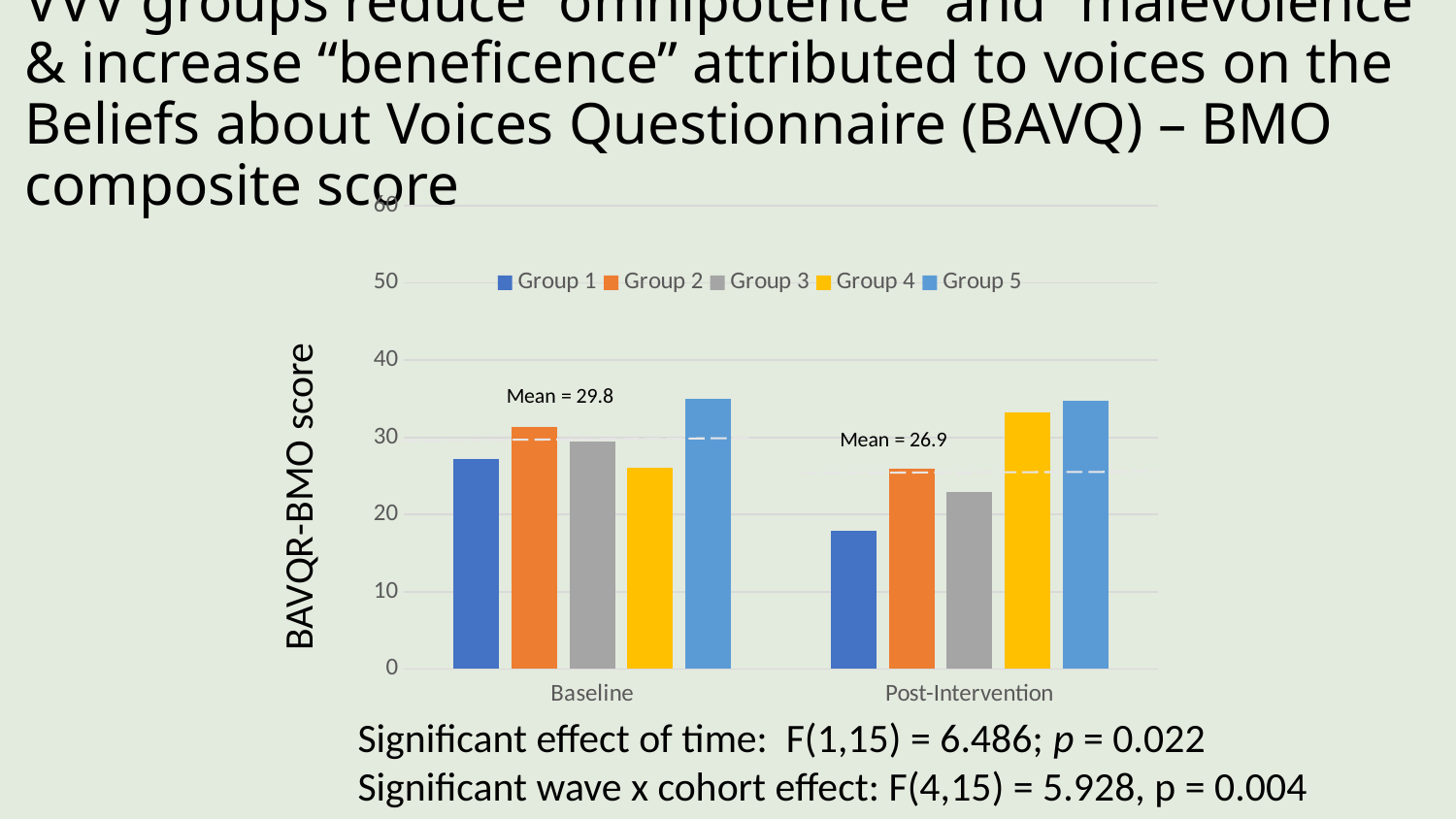
Is the Post-Intervention value for Group 1 greater or less than 20? less What kind of chart is shown on the slide? Bar chart Is the Baseline value for Group 5 greater or less than 30? greater For Group 4, is the score larger at Baseline or at Post-Intervention? Post-Intervention What is the mean BAVQR-BMO score shown for Baseline? 29.8 Which group has the highest BAVQR-BMO score at Baseline? Group 5 Which group has the lowest BAVQR-BMO score at Post-Intervention? Group 1 What is the mean BAVQR-BMO score shown for Post-Intervention? 26.9 What is the label on the y axis of the chart? BAVQR-BMO score What is the difference between the Baseline mean and the Post-Intervention mean? 2.9 How many series does the chart legend list? 5 How many categories are shown on the x axis of the chart? 2